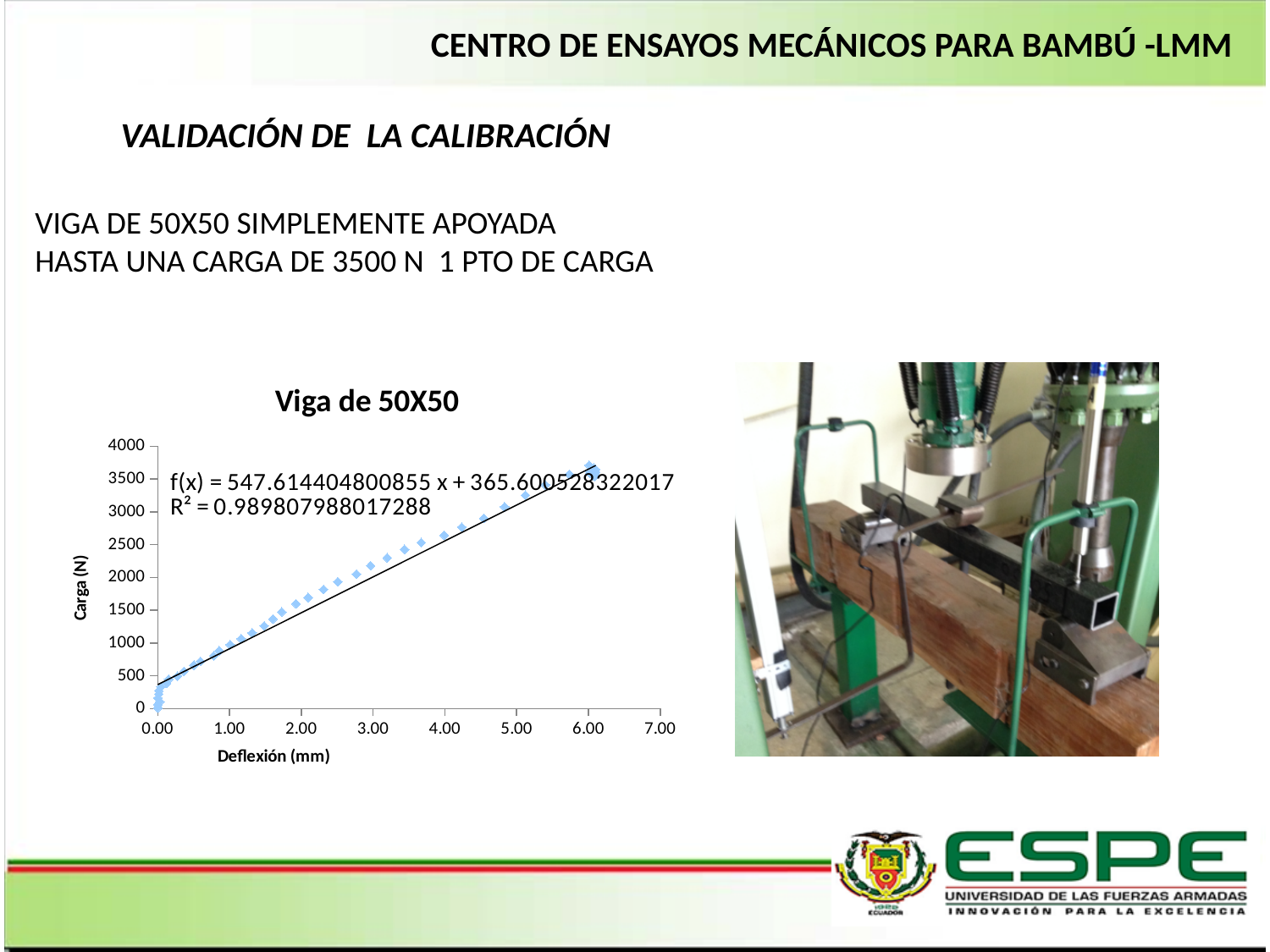
What is the highest value shown on the x axis of the chart? 7.00 What is the slope of the fitted line equation shown on the chart? 547.614404800855 Is the load value at a deflection of about 3.00 mm greater or less than 1500? greater What is the highest value shown on the y axis of the chart? 4000 What is the R² value shown on the chart? 0.989807988017288 Does the load (Carga) rise or fall as deflection increases along the x axis? rise Is the load value at a deflection of about 6.00 mm greater or less than 3500? greater Is the load value at a deflection of about 1.00 mm greater or less than 1500? less What is the label of the x axis of the chart? Deflexión (mm) What is the title of the chart? Viga de 50X50 What is the intercept of the fitted line equation shown on the chart? 365.600528322017 What kind of chart is shown on the slide? scatter chart